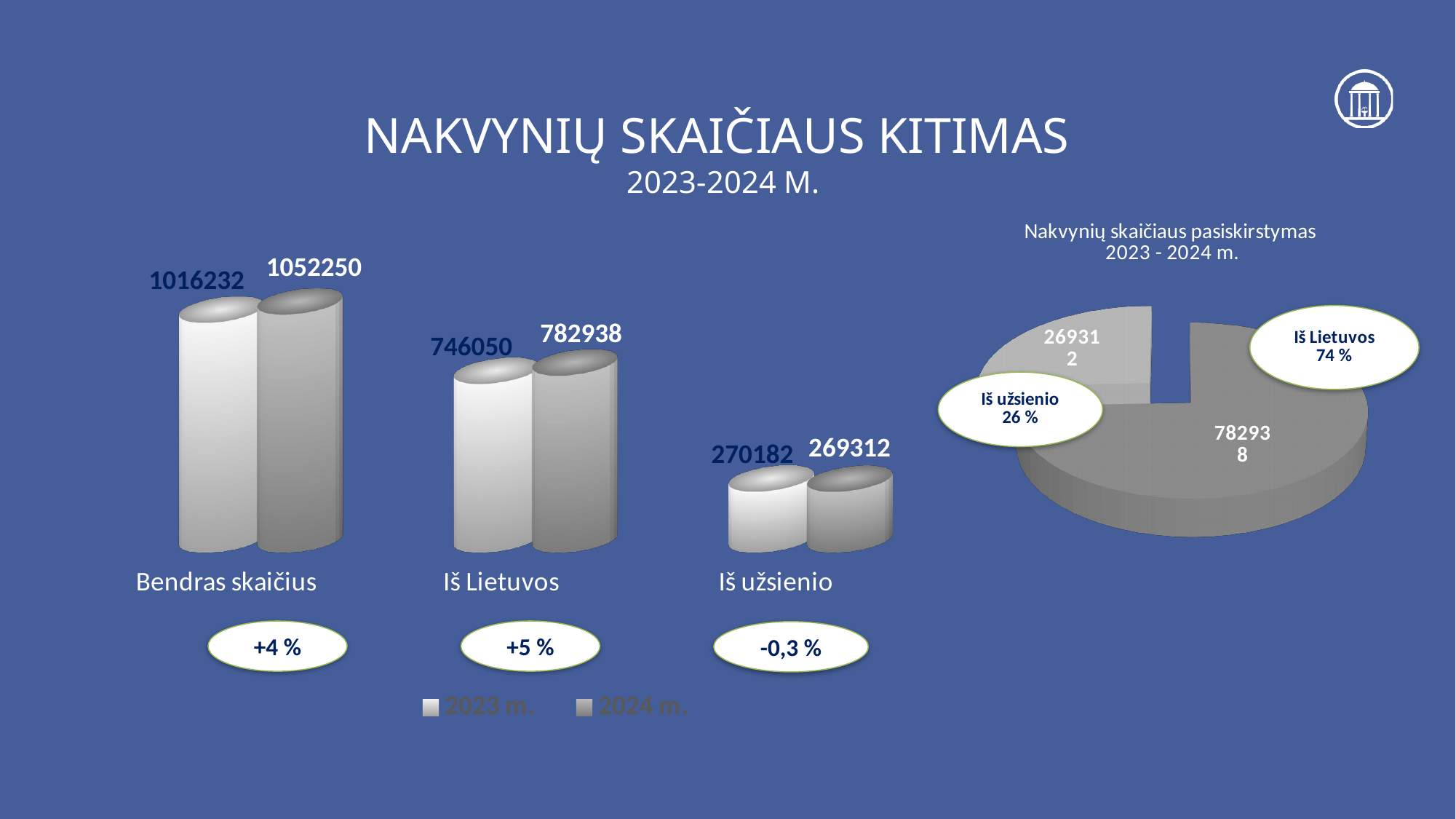
In the bar chart on the left, which category has the highest 2023 m. value? Bendras skaičius In the bar chart on the left, which category has the lowest 2024 m. value? Iš užsienio In the bar chart on the left, what is the difference between the 2024 m. and 2023 m. values for Bendras skaičius? 36018 In the pie chart titled 'Nakvynių skaičiaus pasiskirstymas 2023 - 2024 m.', what share does Iš Lietuvos have? 74 % In the bar chart on the left, what is the 2023 m. value for Iš Lietuvos? 746050 How many series does the legend of the bar chart on the left list? 2 In the bar chart on the left, which is larger for Iš užsienio: the 2023 m. value or the 2024 m. value? 2023 m. In the bar chart on the left, what is the difference between the 2024 m. and 2023 m. values for Iš Lietuvos? 36888 In the bar chart on the left, what is the 2023 m. value for Iš užsienio? 270182 In the bar chart on the left, what is the 2024 m. value for Bendras skaičius? 1052250 In the pie chart titled 'Nakvynių skaičiaus pasiskirstymas 2023 - 2024 m.', what is the value of the Iš užsienio slice? 269312 How many categories does the bar chart on the left show? 3